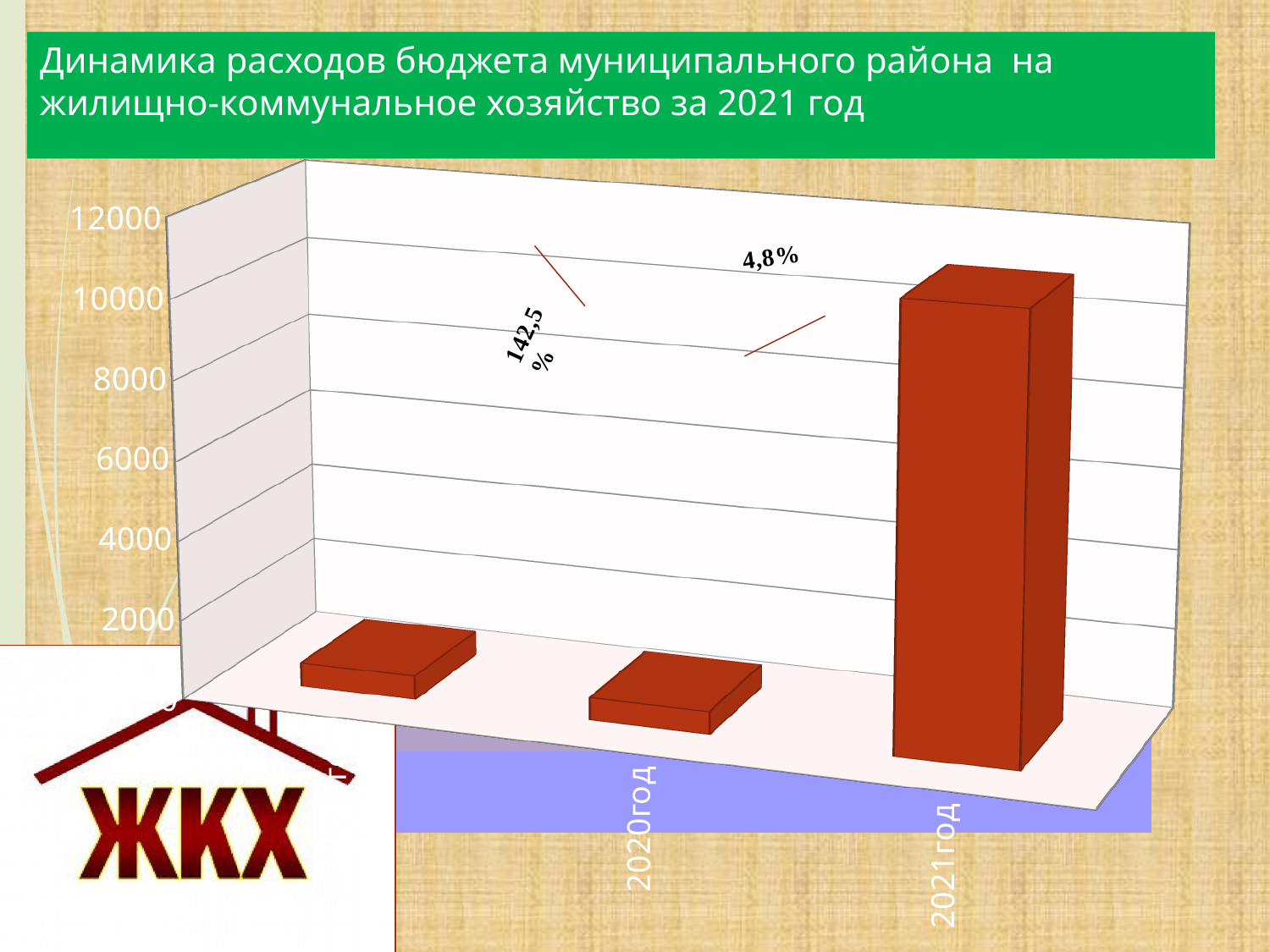
What kind of chart is shown on the slide? bar chart Does the value rise or fall from 2020год to 2021год? rise Is the value for 2020год greater or less than 2000? less Which is larger, the value for 2020год or the value for 2021год? 2021год What percentage annotation is written near the top of the chart, to the right of the 142,5 % label? 4,8% Is the value for 2021год greater or less than 12000? less What is the highest value shown on the vertical axis of the chart? 12000 How many bars are plotted in the chart? 3 Which category has the highest bar in the chart? 2021год Is the value for 2021год greater or less than 8000? greater